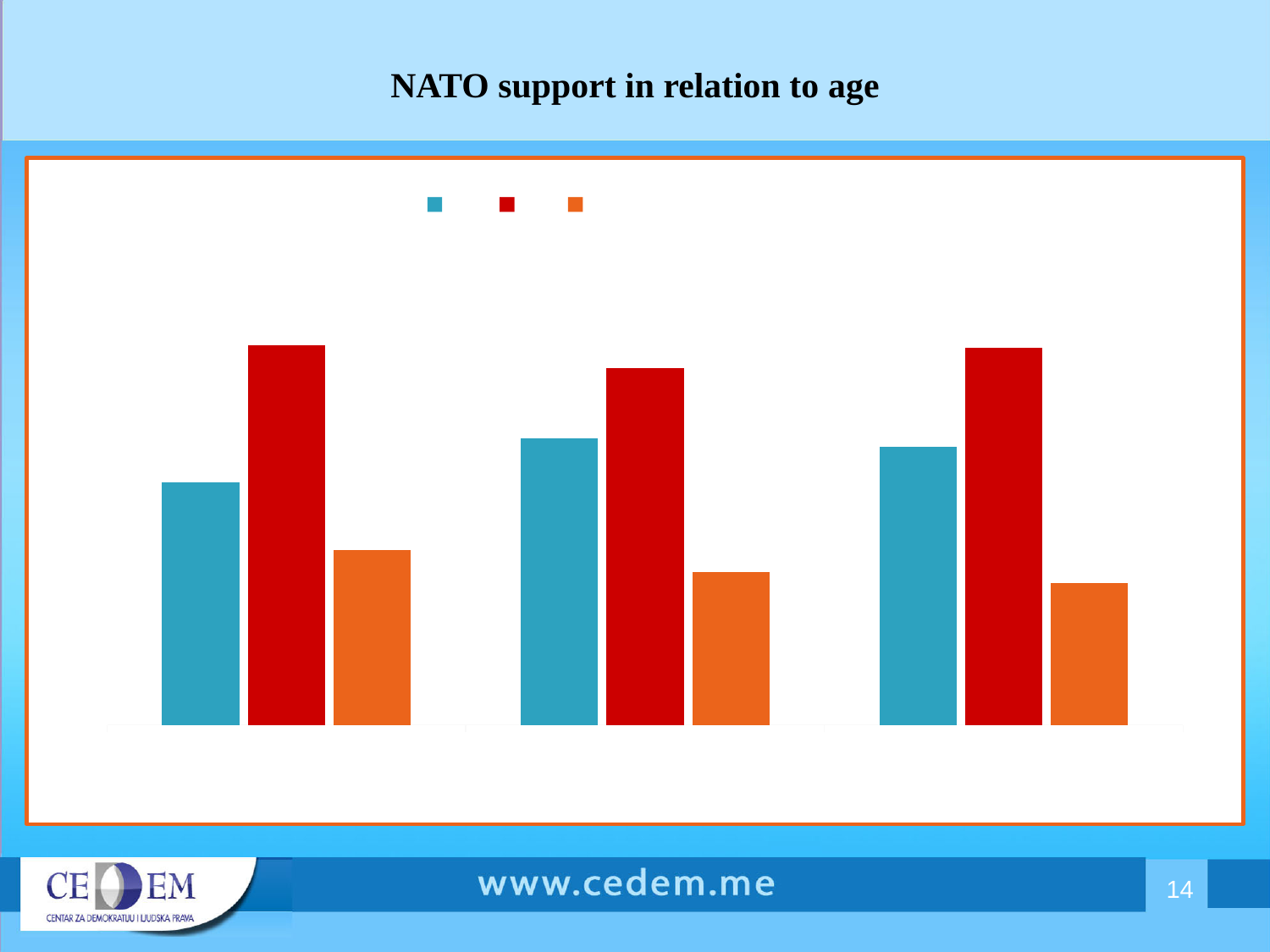
In the middle group of bars, which colour bar is the tallest? red How many groups of bars are plotted along the x axis? 3 What is the title of the chart? NATO support in relation to age Among the three teal bars, which group has the shortest one: leftmost, middle or rightmost? leftmost In the rightmost group of bars, which colour bar is the shortest? orange Among the three red bars, which group has the shortest one: leftmost, middle or rightmost? middle How many bars are plotted in total on the chart? 9 How many series does the legend list? 3 In the rightmost group, is the teal bar or the red bar taller? red In the leftmost group of bars, which colour bar is the tallest? red What kind of chart is shown on the slide? bar chart